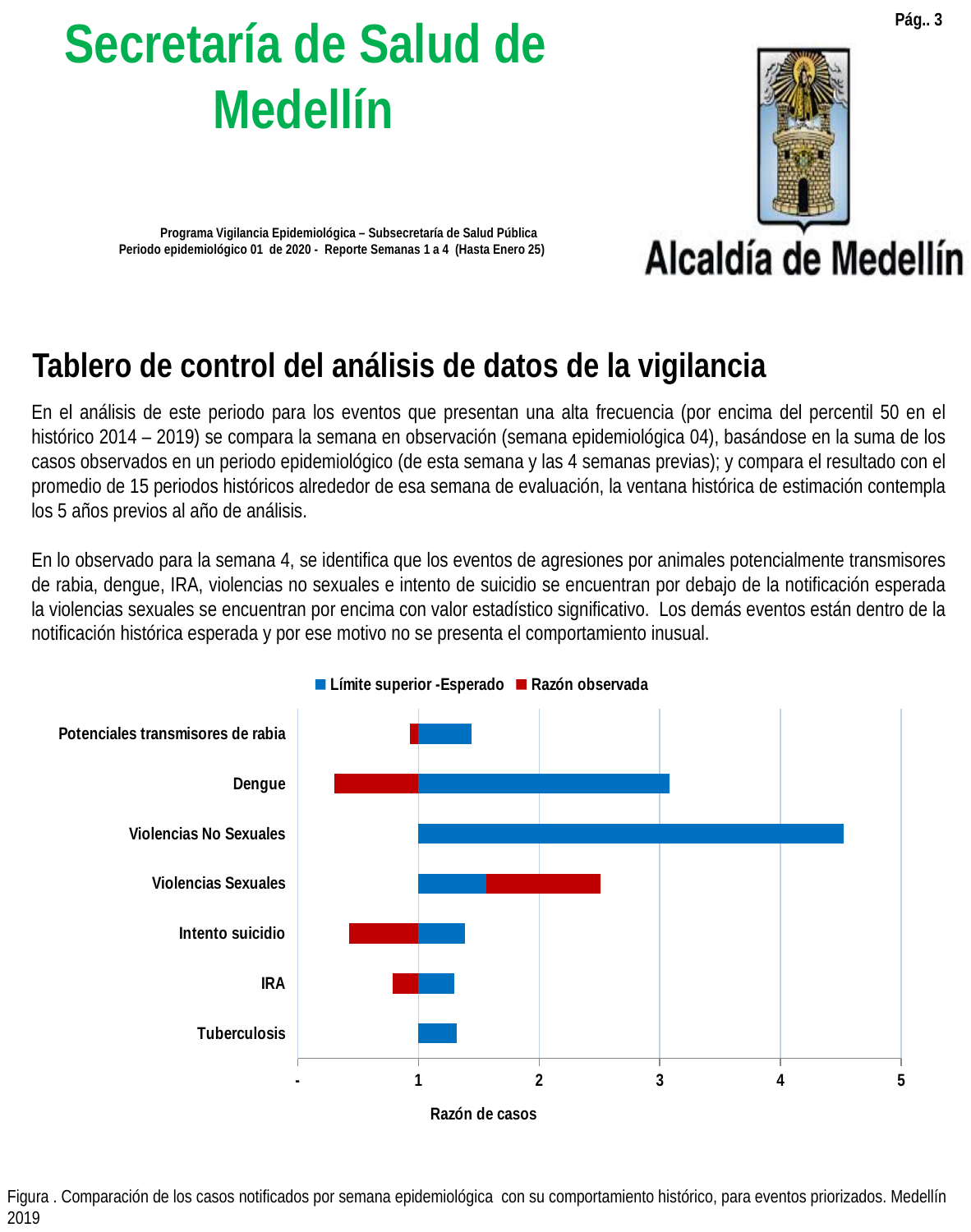
Is the Razón observada value for Intento suicidio greater or less than 1? less How many series does the chart legend list? 2 What colour represents the Razón observada series in the chart? red Which has a larger Límite superior -Esperado value, Dengue or Violencias No Sexuales? Violencias No Sexuales Is the Límite superior -Esperado value for Dengue greater or less than 2? greater Is the Límite superior -Esperado value for Violencias No Sexuales greater or less than 4? greater Which category has the highest value for Límite superior -Esperado? Violencias No Sexuales Which has a larger Razón observada value, Violencias Sexuales or IRA? Violencias Sexuales How many categories (events) are plotted on the chart? 7 What is the title of the horizontal axis of the chart? Razón de casos What kind of chart is shown on the slide? bar chart